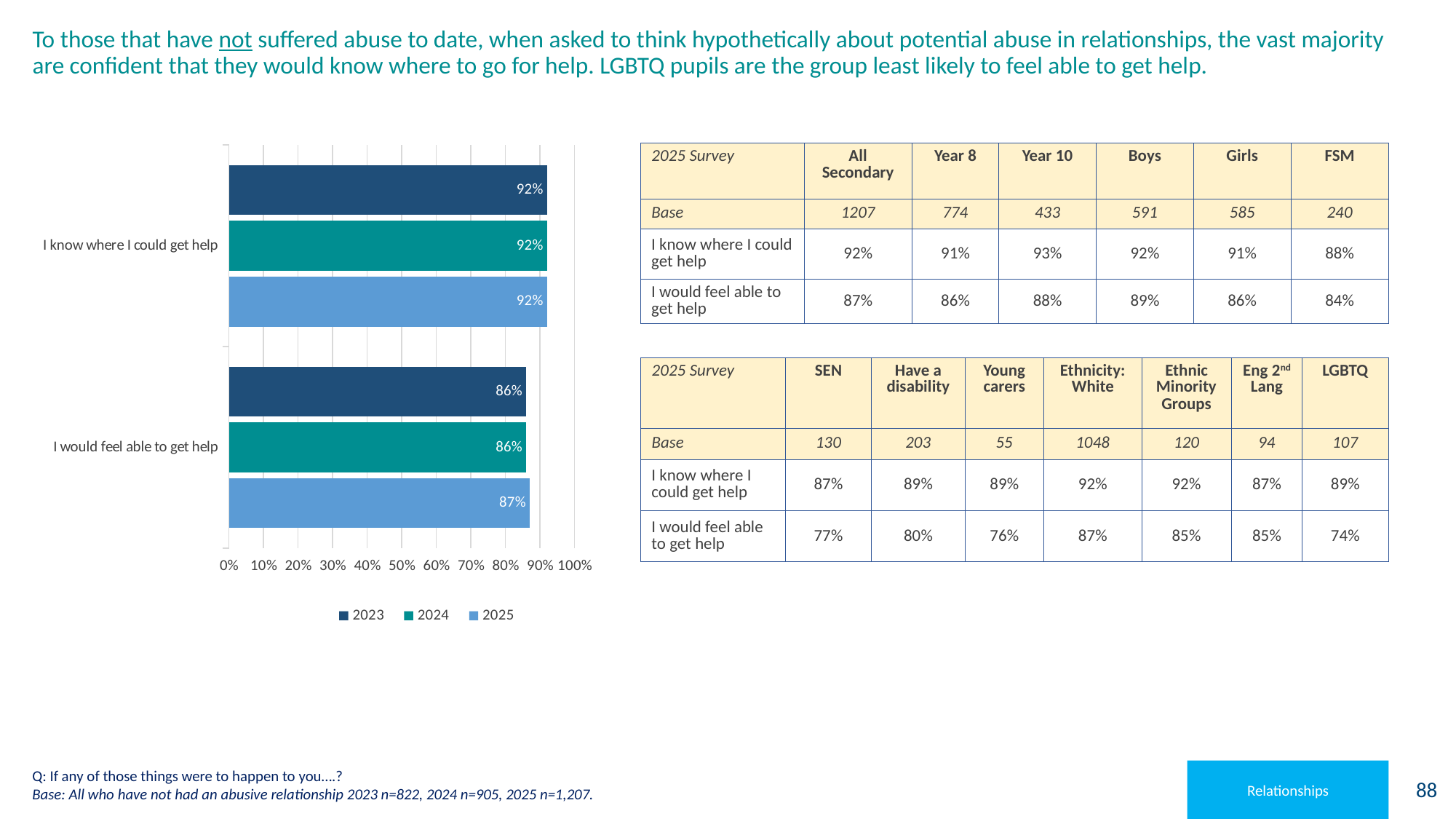
Which category has the lower 2023 value, 'I know where I could get help' or 'I would feel able to get help'? I would feel able to get help What is the 2024 value for 'I would feel able to get help'? 86% Which series is shown in the lightest blue colour in the chart legend? 2025 What is the 2025 value for 'I would feel able to get help'? 87% How many series does the chart legend list? 3 What is the 2023 value for 'I know where I could get help'? 92% What is the difference between the 2025 and 2023 values for 'I would feel able to get help'? 1% What is the 2025 value for 'I know where I could get help'? 92% What kind of chart is shown on the slide? bar chart What is the difference between the 2025 values for 'I know where I could get help' and 'I would feel able to get help'? 5% How many categories are plotted on the chart? 2 Is the 2024 value for 'I would feel able to get help' greater or less than 80%? greater